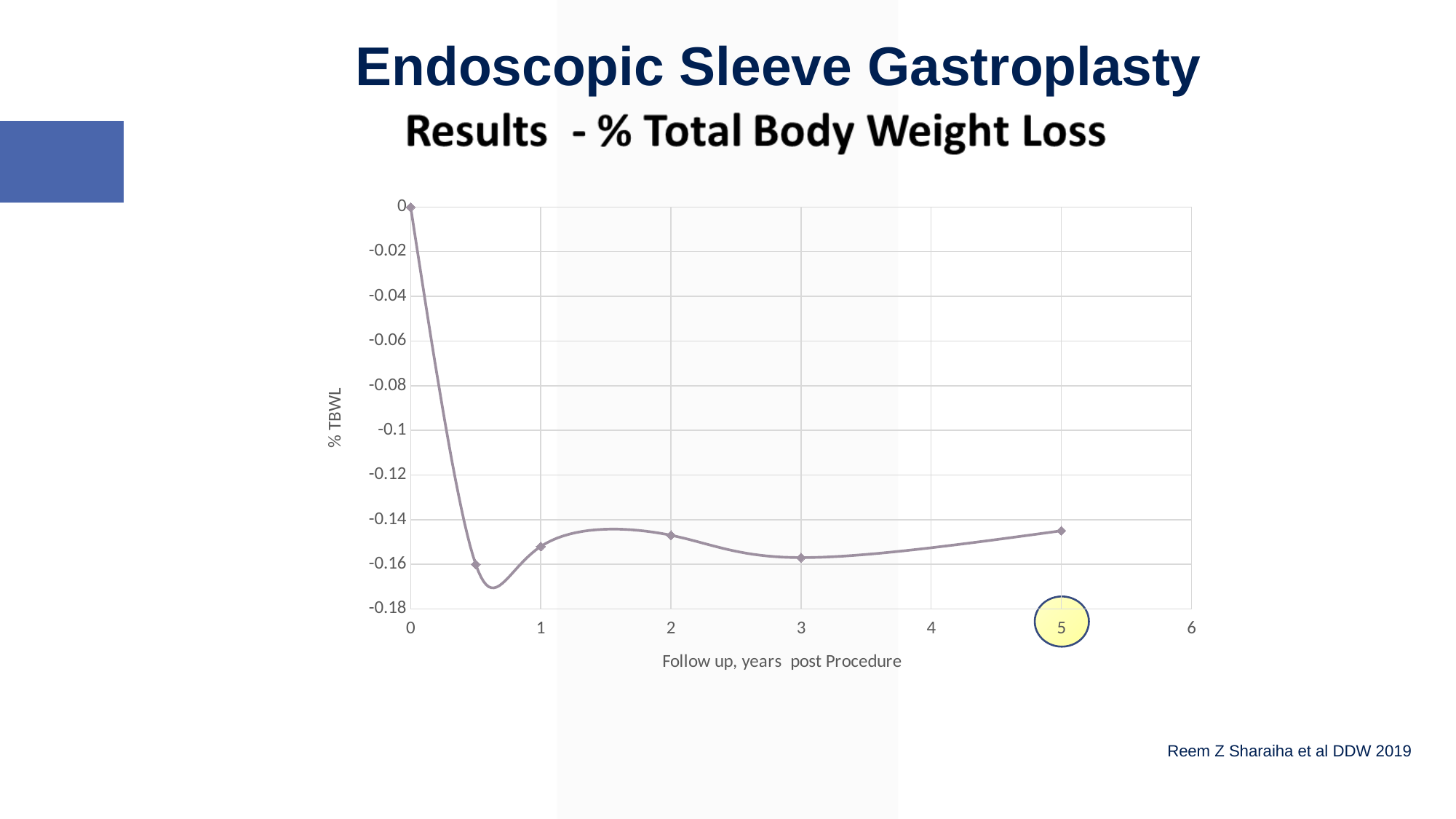
Is the % TBWL value at 1 year greater or less than -0.14? less What kind of chart is shown on the slide? line chart Which has the larger % TBWL value, 5 years or 3 years of follow up? 5 years What is the label of the x axis? Follow up, years post Procedure Is the % TBWL value at 5 years greater or less than -0.16? greater How many data points are plotted on the chart? 6 What is the % TBWL value at 0 years of follow up? 0 Is the % TBWL value at 3 years greater or less than -0.14? less At which follow-up time is the % TBWL value highest? 0 years Does the % TBWL value rise or fall between 0 and 0.5 years of follow up? fall What is the label of the y axis? % TBWL